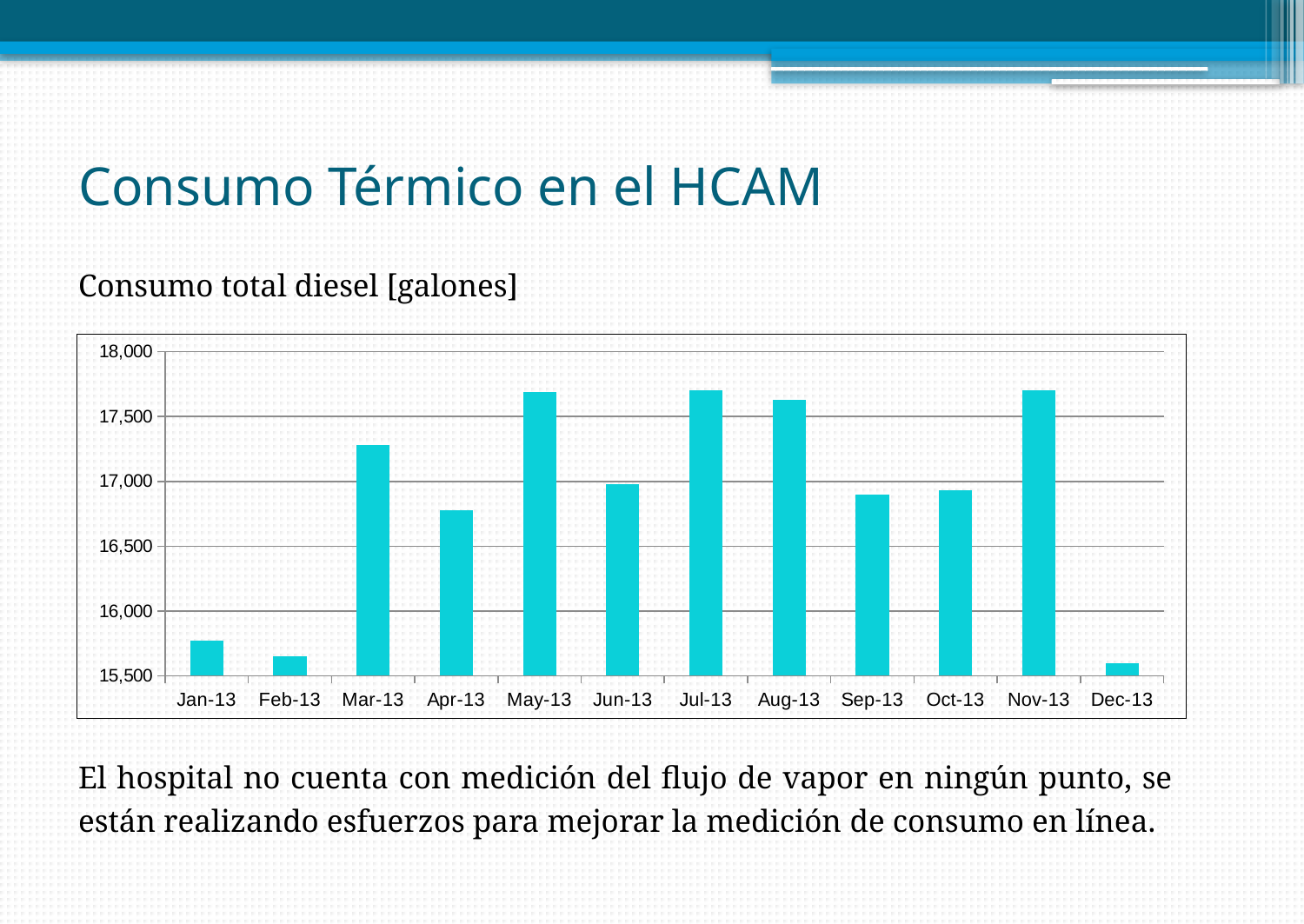
Is the value for Dec-13 greater or less than 16,000? less Is the value for Mar-13 greater or less than 17,000? greater What kind of chart is shown on the slide? bar chart What is the title given above the chart? Consumo total diesel [galones] Is the value for May-13 greater or less than 17,500? greater Which is larger, the value for Aug-13 or the value for Sep-13? Aug-13 How many months are plotted on the x axis of the chart? 12 Do the values rise or fall from Nov-13 to Dec-13? fall Which is larger, the value for Mar-13 or the value for Apr-13? Mar-13